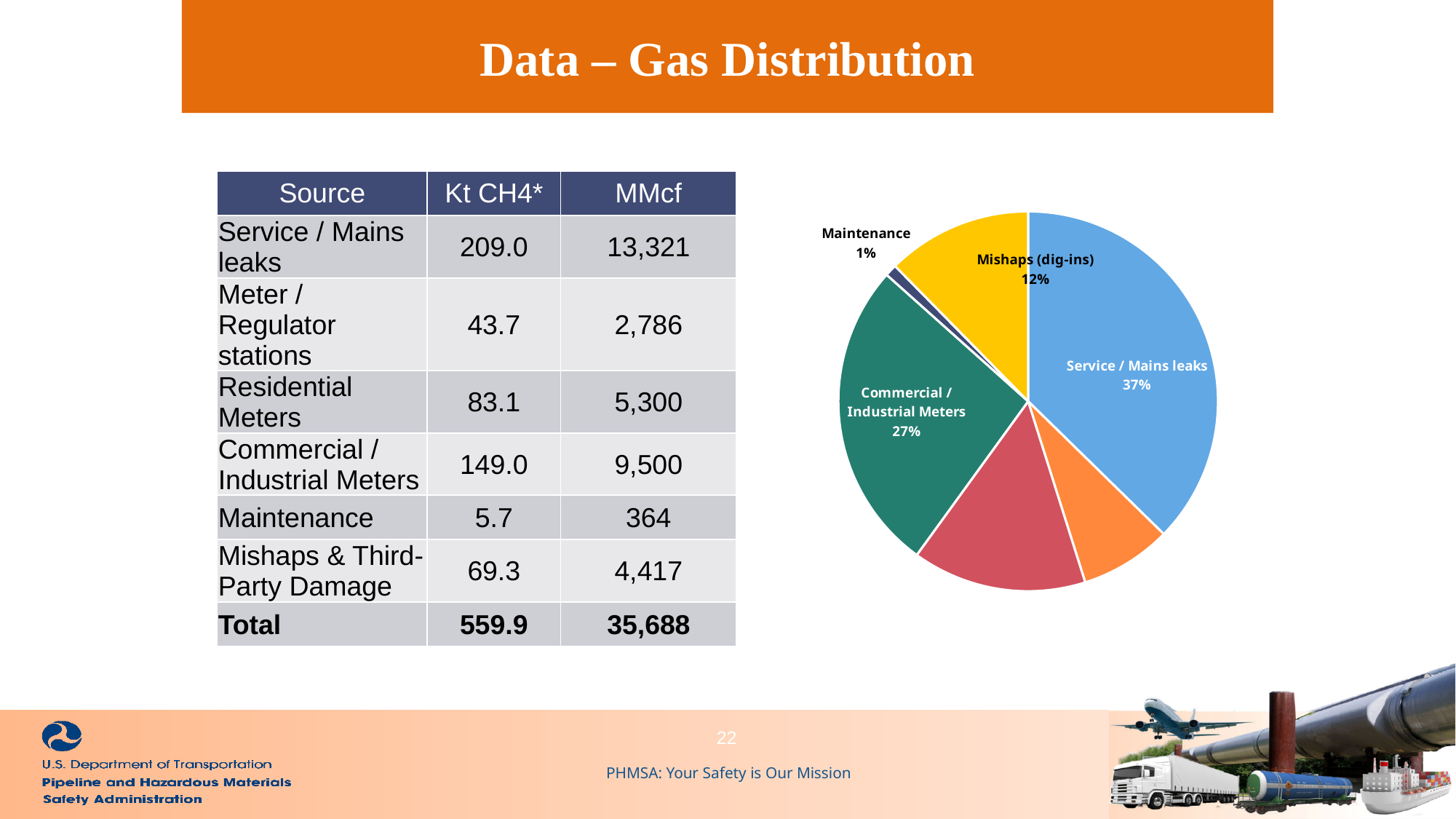
Which is larger in the pie chart, Commercial / Industrial Meters or Mishaps (dig-ins)? Commercial / Industrial Meters Which slice of the pie chart is the largest? Service / Mains leaks Which slice of the pie chart is the smallest? Maintenance What share of the pie does Commercial / Industrial Meters represent? 27% What colour is the Service / Mains leaks slice in the pie chart? light blue How many slices does the pie chart have? 6 What share of the pie does Mishaps (dig-ins) represent? 12% What share of the pie does Service / Mains leaks represent? 37% How many percentage points larger is the Commercial / Industrial Meters share than the Mishaps (dig-ins) share? 15 How many percentage points larger is the Service / Mains leaks share than the Commercial / Industrial Meters share? 10 What kind of chart is shown on the slide? pie chart